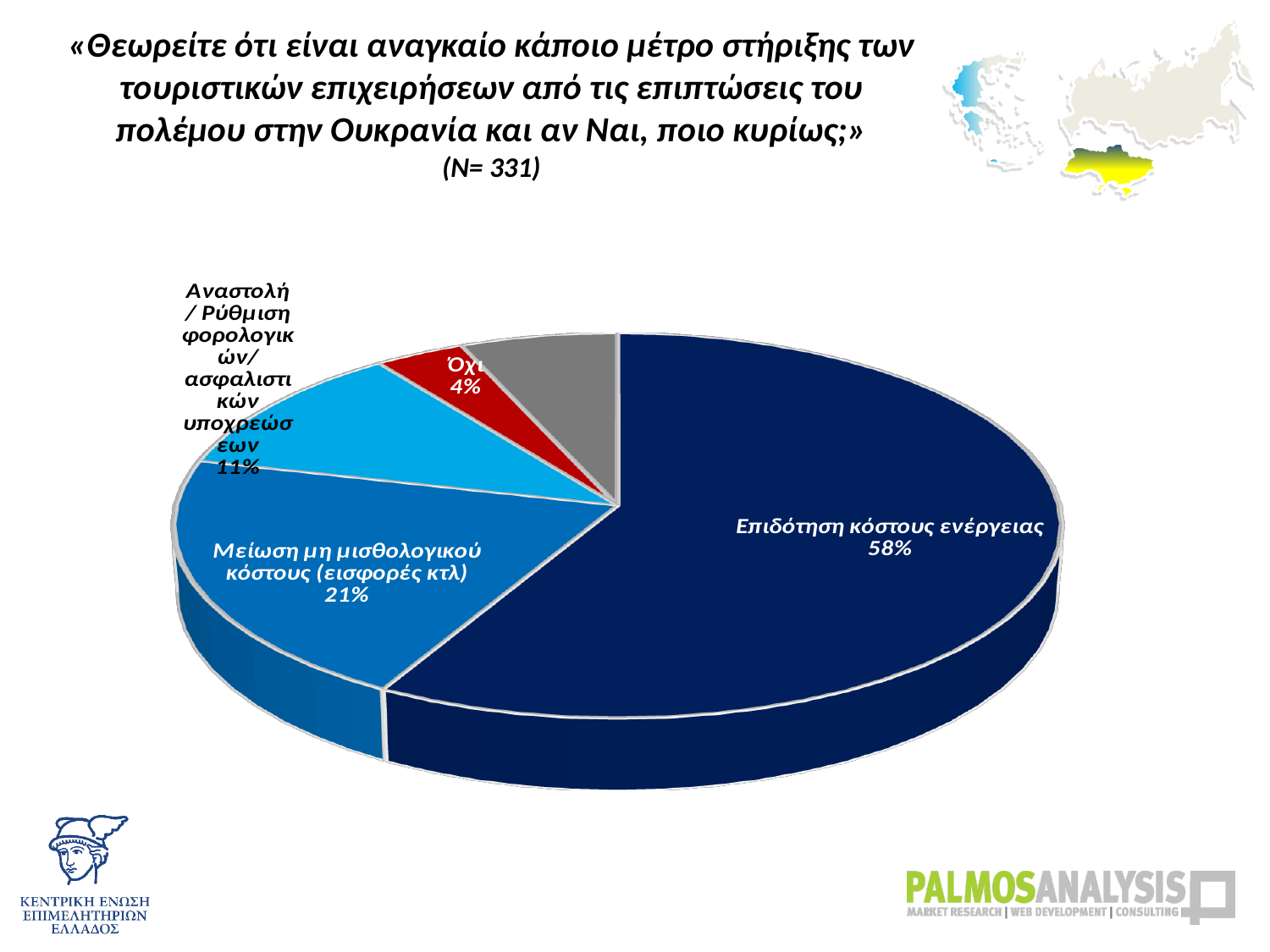
How many percentage points larger is «Επιδότηση κόστους ενέργειας» than «Μείωση μη μισθολογικού κόστους (εισφορές κτλ)»? 37 percentage points What is the sample size (N) stated under the chart title? 331 How many slices does the pie chart have? 5 Which response has the largest share of the pie? Επιδότηση κόστους ενέργειας What kind of chart is shown on the slide? Pie chart What is the combined share of the four labelled slices? 94% Which is larger: the share for «Μείωση μη μισθολογικού κόστους» or the share for «Αναστολή / Ρύθμιση φορολογικών/ασφαλιστικών υποχρεώσεων»? Μείωση μη μισθολογικού κόστους What percentage is shown for «Μείωση μη μισθολογικού κόστους (εισφορές κτλ)»? 21% Which labelled response has the smallest share of the pie? Όχι What percentage of respondents answered «Όχι»? 4% What percentage is shown for «Αναστολή / Ρύθμιση φορολογικών/ασφαλιστικών υποχρεώσεων»? 11% What percentage of respondents chose «Επιδότηση κόστους ενέργειας»? 58%